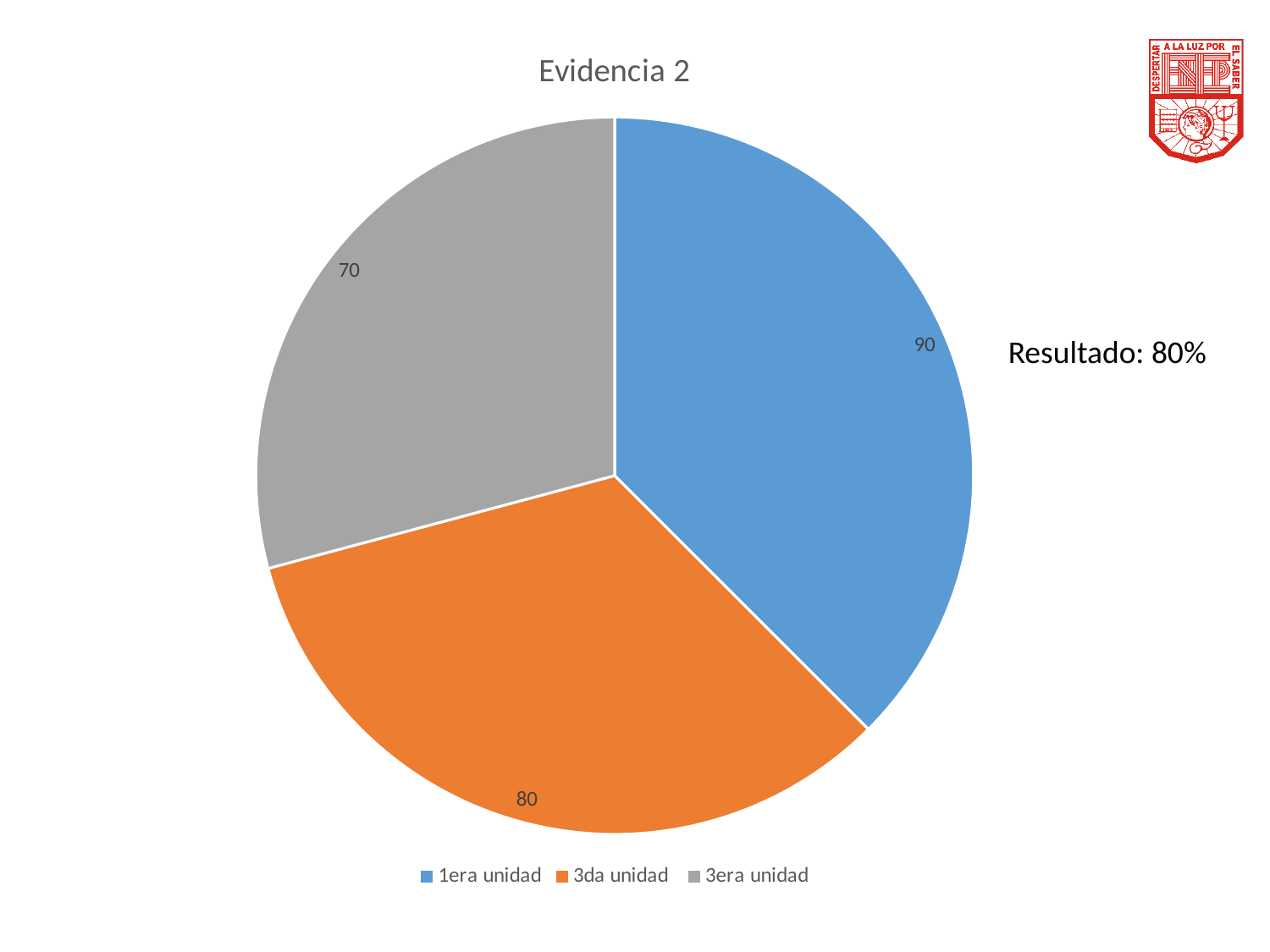
What is the title of the chart? Evidencia 2 Which category has the smallest slice of the pie? 3era unidad Which category has the largest slice of the pie? 1era unidad What colour is the slice for 3da unidad? Orange What is the difference between the values for 1era unidad and 3era unidad? 20 Which is larger, the value for 3da unidad or the value for 3era unidad? 3da unidad What is the total of all the slice values in the pie chart? 240 How many slices does the pie chart have? 3 What is the value for 3da unidad? 80 What type of chart is shown on the slide? Pie chart What is the value for 3era unidad? 70 What is the value for 1era unidad? 90